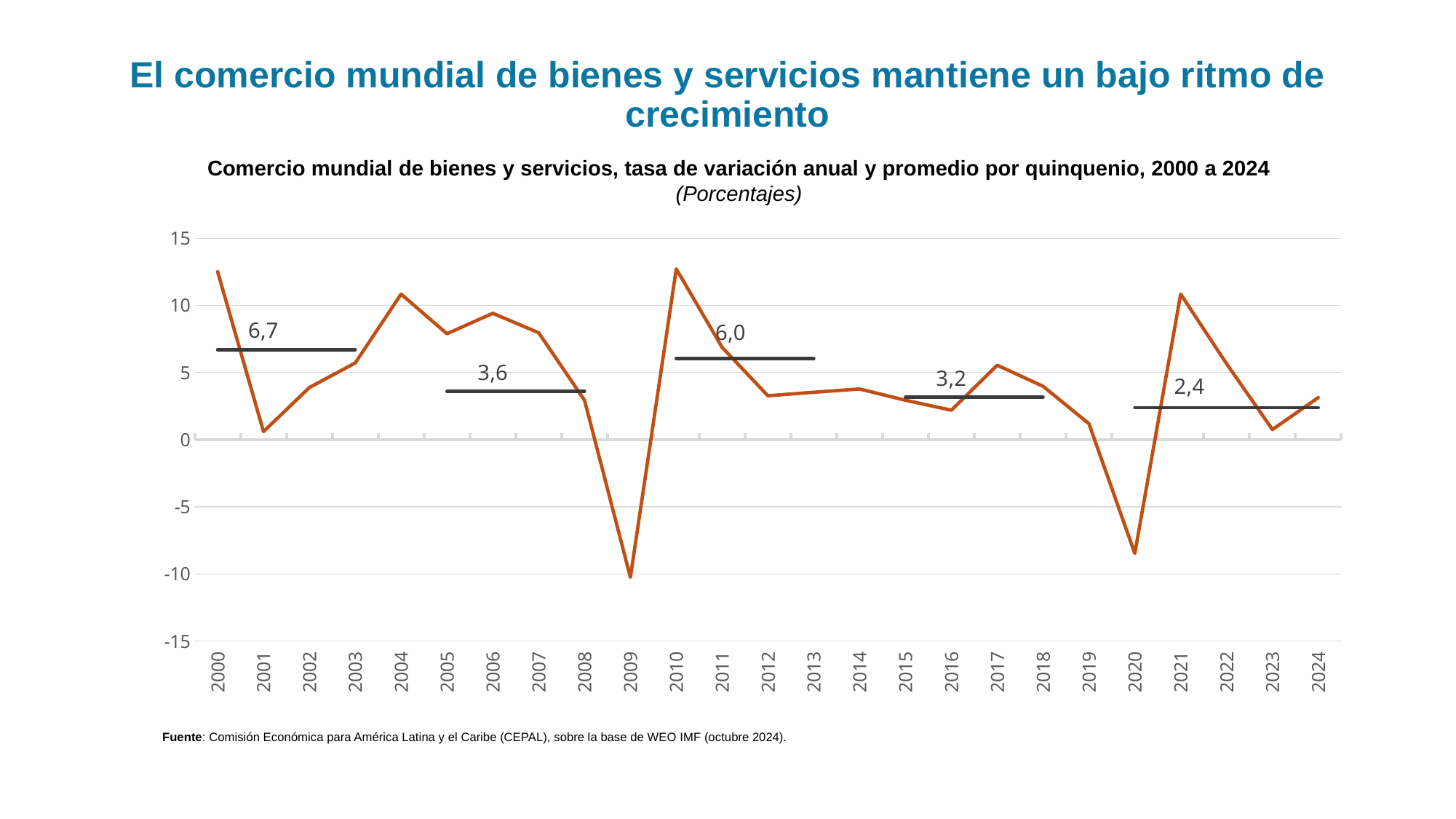
What is the five-year average value labelled for the 2010–2014 period? 6,0 What is the five-year average value labelled for the 2020–2024 period? 2,4 What is the five-year average value labelled for the 2000–2004 period? 6,7 What kind of chart is shown on the slide? line chart Is the labelled average for 2010–2014 (6,0) larger or smaller than the labelled average for 2015–2019 (3,2)? larger What is the difference between the labelled averages 6,7 and 3,2? 3,5 Which year shows the lowest annual value on the line? 2009 Which labelled five-year average is the lowest? 2,4 What is the five-year average value labelled for the 2005–2009 period? 3,6 Which labelled five-year average is the highest? 6,7 Is the value for 2000 greater or less than 10? greater Is the value for 2009 greater or less than -5? less